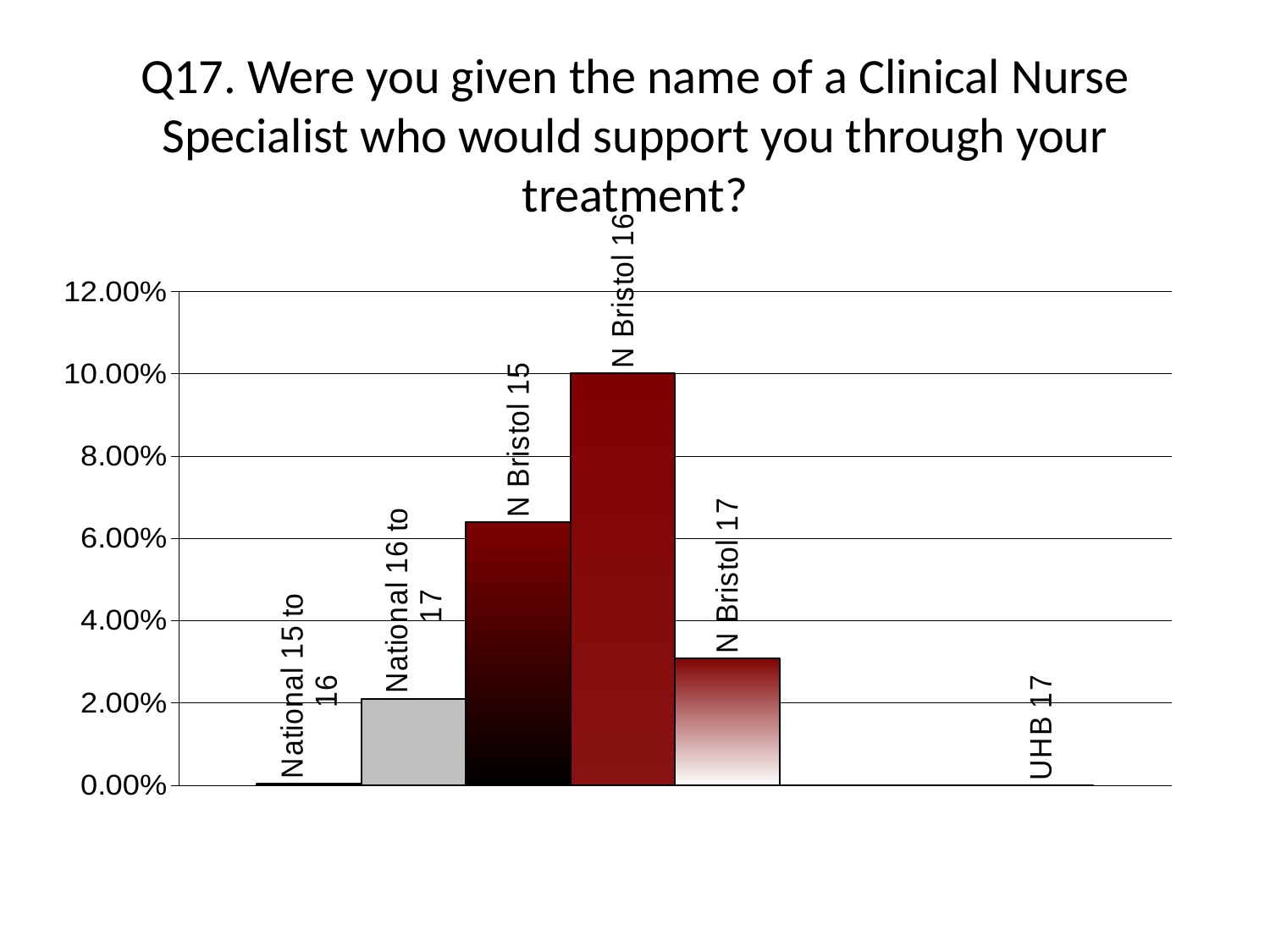
Is the value for National 16 to 17 greater or less than 4.00%? less How many categories are plotted in the chart? 6 What is the title of the chart? Q17. Were you given the name of a Clinical Nurse Specialist who would support you through your treatment? Which is larger, the value for N Bristol 15 or the value for N Bristol 17? N Bristol 15 Which category has the highest value in the chart? N Bristol 16 Which is larger, the value for National 16 to 17 or the value for N Bristol 16? N Bristol 16 Is the value for N Bristol 17 greater or less than 4.00%? less What is the highest value shown on the vertical axis? 12.00% What kind of chart is shown on the slide? bar chart Is the value for N Bristol 15 greater or less than 4.00%? greater